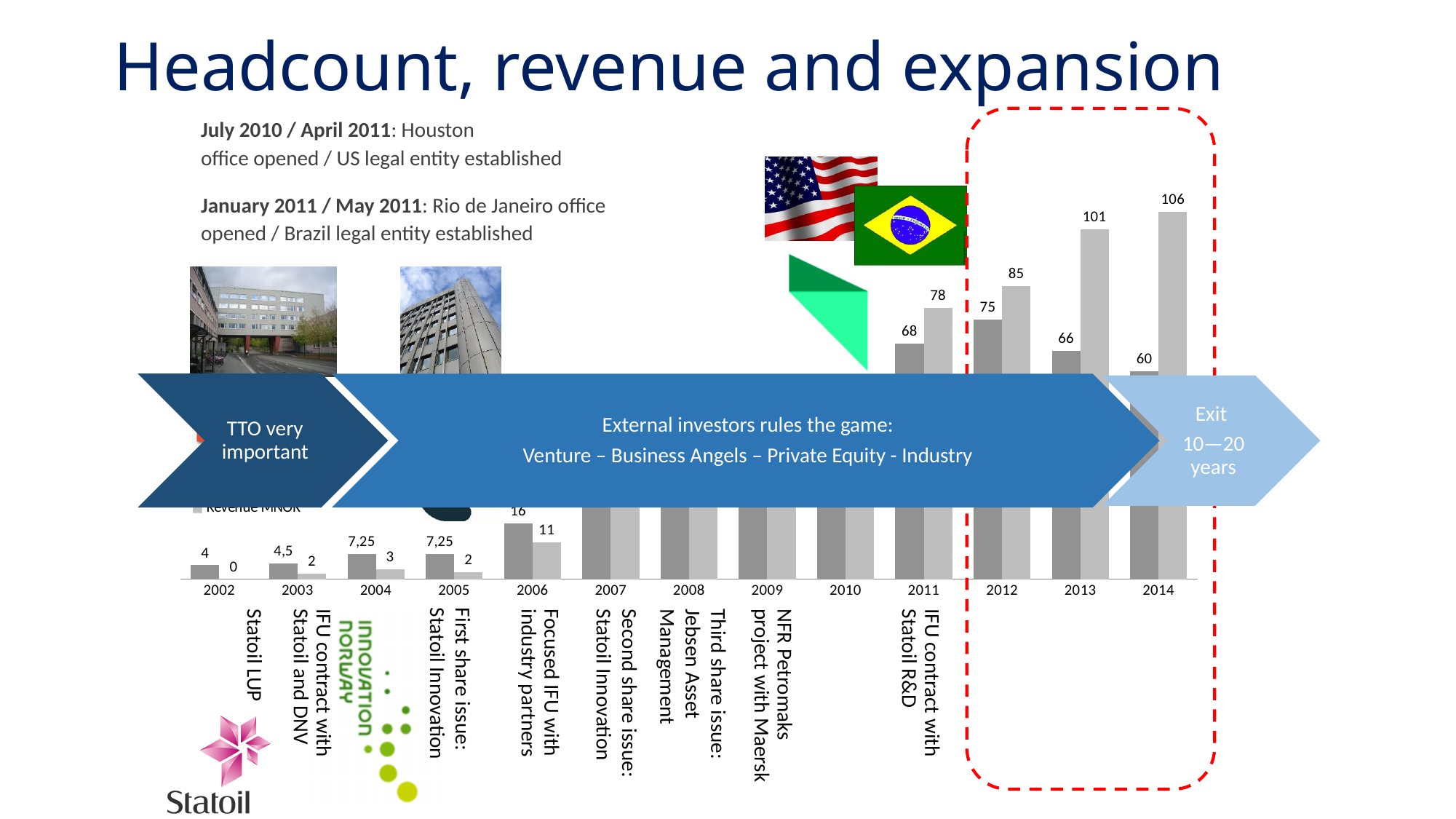
Which year has the highest light grey Revenue MNOK bar? 2014 Which is larger in 2011: the dark grey bar or the light grey Revenue MNOK bar? the light grey Revenue MNOK bar How many years are shown on the x axis of the chart? 13 What type of chart is shown on the slide? bar chart What is the difference between the light grey Revenue MNOK values for 2014 and 2013? 5 What is the value of the dark grey bar for 2012? 75 What is the value of the light grey Revenue MNOK bar for 2006? 11 Do the light grey Revenue MNOK values rise or fall from 2011 to 2014? rise What is the value of the light grey Revenue MNOK bar for 2014? 106 What is the value of the dark grey bar for 2004? 7,25 What is the first year shown on the chart's x axis? 2002 Which year has the lowest light grey Revenue MNOK bar? 2002